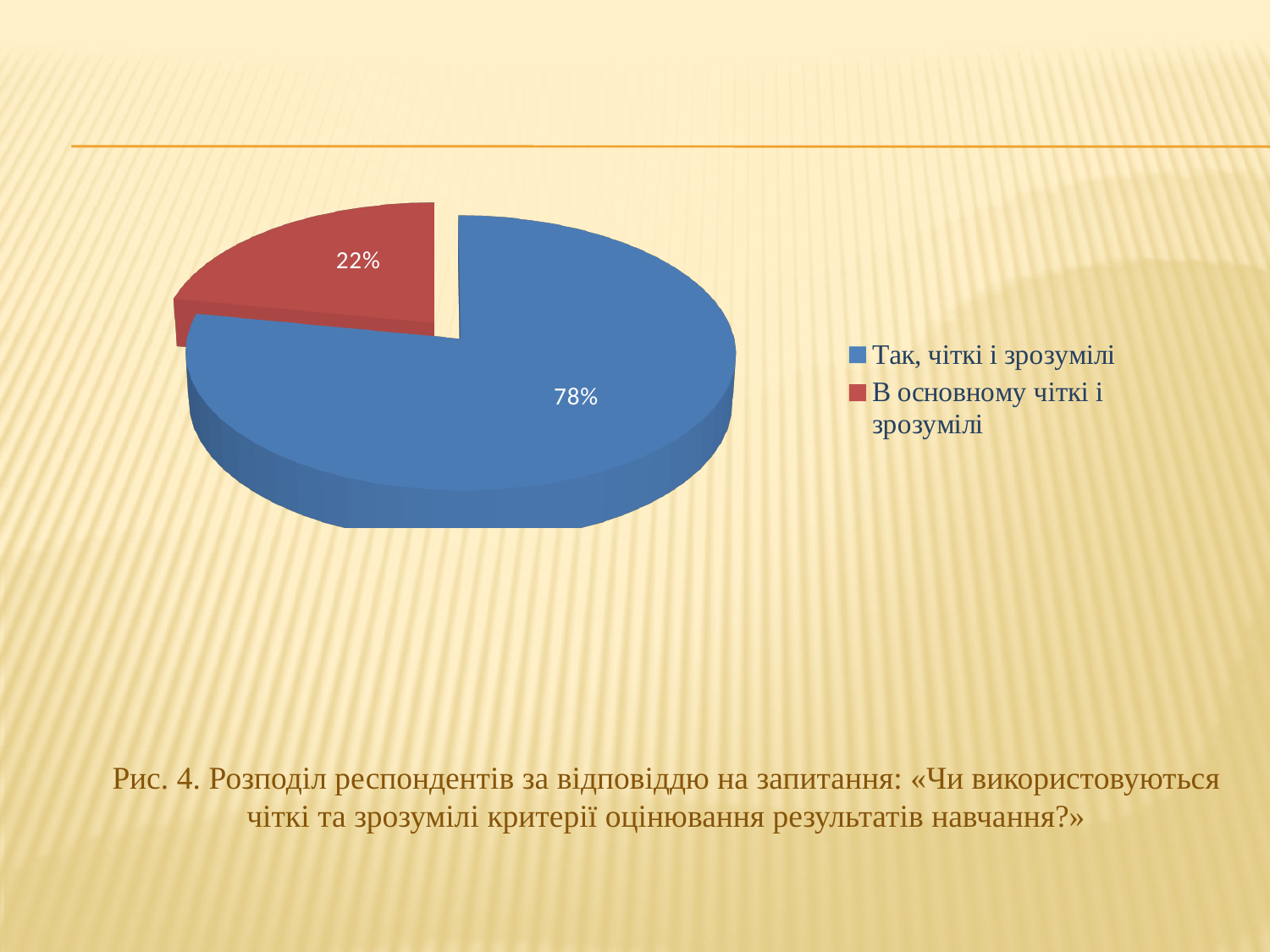
What share of respondents answered "Так, чіткі і зрозумілі"? 78% Which is larger: the share for "Так, чіткі і зрозумілі" or for "В основному чіткі і зрозумілі"? Так, чіткі і зрозумілі How many slices does the pie chart have? 2 What colour is the slice for "В основному чіткі і зрозумілі"? Red How many entries does the legend list? 2 Which answer option has the smallest share of the pie? В основному чіткі і зрозумілі What is the difference in percentage points between the "Так, чіткі і зрозумілі" slice and the "В основному чіткі і зрозумілі" slice? 56 percentage points What kind of chart is shown on the slide? Pie chart What colour is the slice for "Так, чіткі і зрозумілі"? Blue Which answer option has the largest share of the pie? Так, чіткі і зрозумілі What share of respondents answered "В основному чіткі і зрозумілі"? 22%